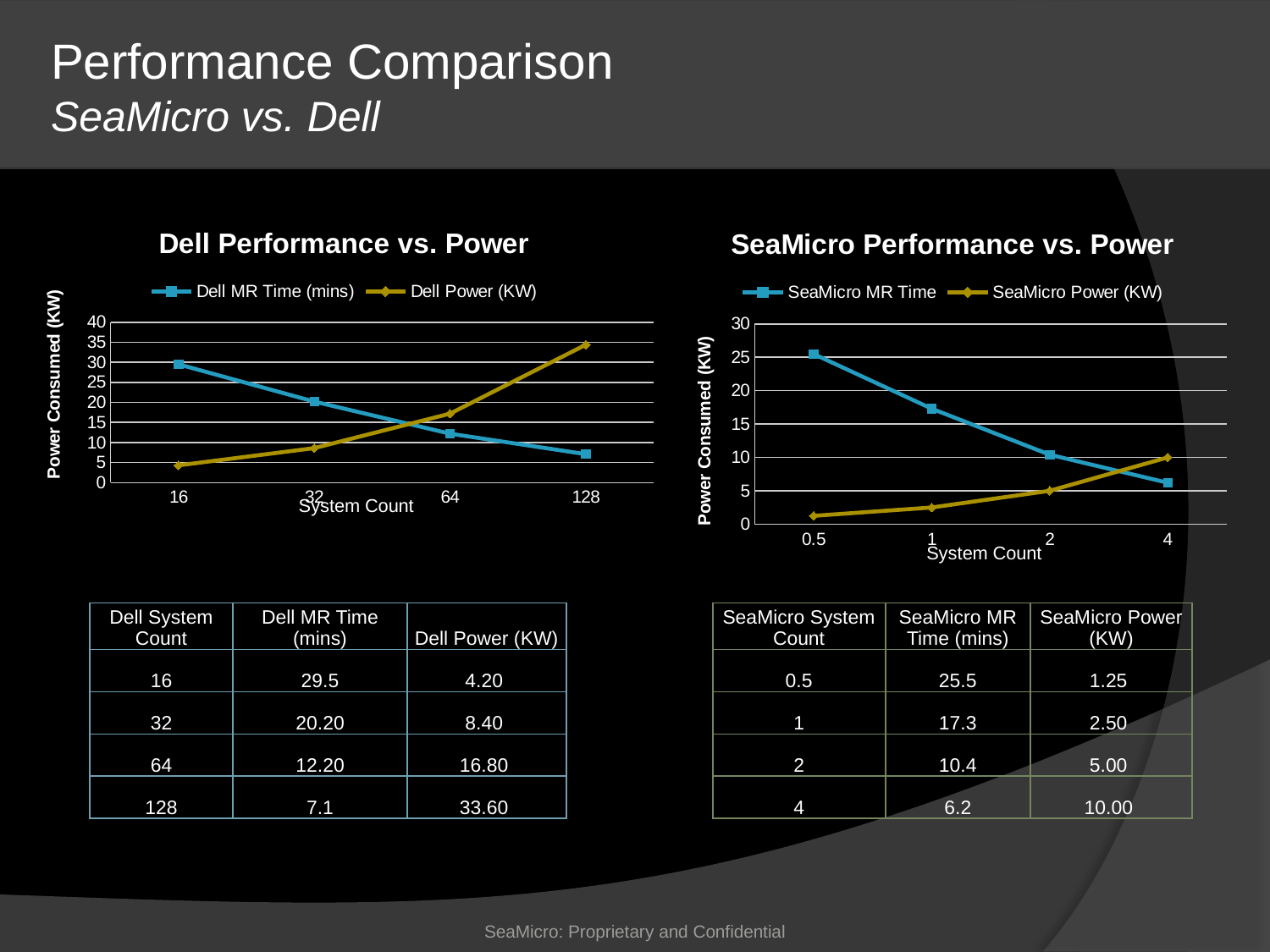
In the 'SeaMicro Performance vs. Power' chart, which is larger at a system count of 2: SeaMicro MR Time or SeaMicro Power? SeaMicro MR Time In the 'Dell Performance vs. Power' chart, does Dell MR Time rise or fall as system count increases? Fall In the 'SeaMicro Performance vs. Power' chart, how many series does the legend list? 2 In the 'Dell Performance vs. Power' chart, how many system count points are plotted on the x axis? 4 In the 'SeaMicro Performance vs. Power' chart, at which system count is SeaMicro MR Time lowest? 4 In the 'Dell Performance vs. Power' chart, what kind of chart is used? Line chart In the 'Dell Performance vs. Power' chart, is the Dell MR Time at a system count of 16 greater or less than 25? greater In the 'Dell Performance vs. Power' chart, at which system count is Dell Power (KW) highest? 128 In the 'SeaMicro Performance vs. Power' chart, what is the SeaMicro MR Time at a system count of 0.5? 25.5 In the 'SeaMicro Performance vs. Power' chart, does SeaMicro Power rise or fall as system count increases? Rise